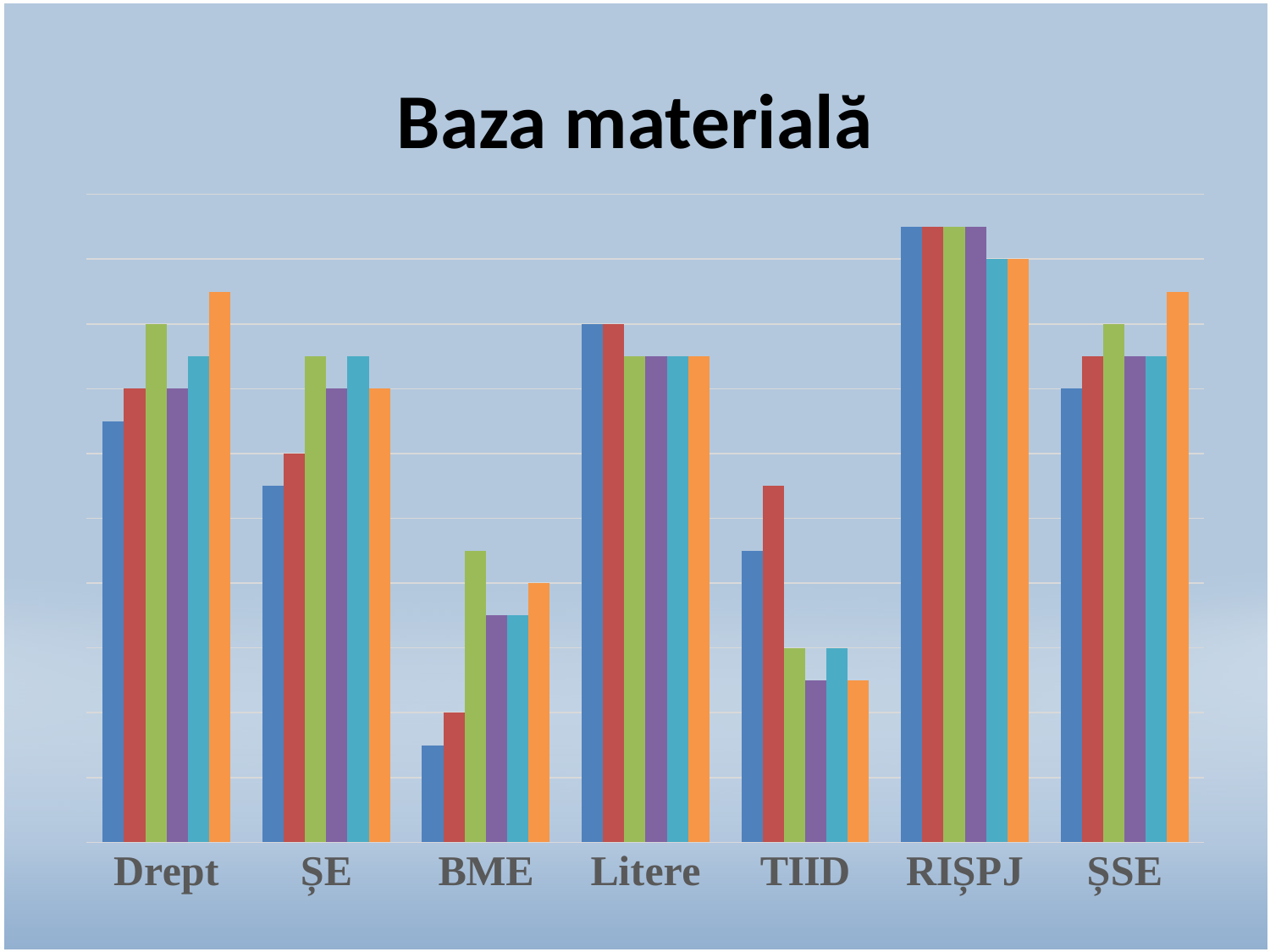
What is the title of the chart? Baza materială How many categories are shown on the x axis of the chart? 7 Is the orange bar for Drept taller or shorter than the orange bar for ȘE? taller Within the BME category, which coloured bar is the tallest? green Which category has the tallest bars in the chart? RIȘPJ Within the Drept category, which coloured bar is the tallest? orange How many bars are plotted for each category in the chart? 6 Which category contains the shortest bar in the chart? BME Which category is labelled first on the x axis of the chart? Drept What kind of chart is shown on the slide? bar chart Is the blue bar for Litere taller or shorter than the blue bar for BME? taller